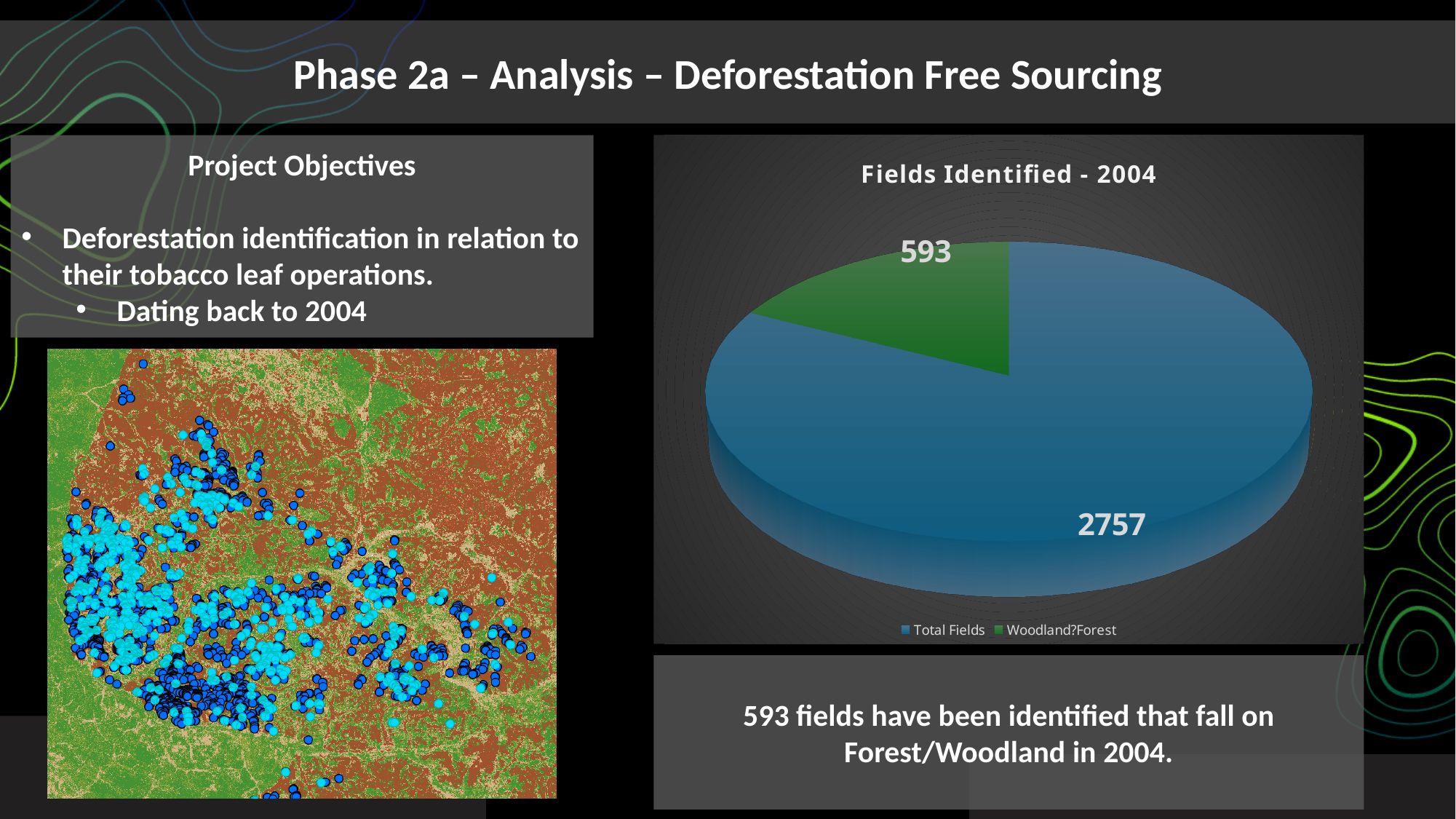
In the "Fields Identified - 2004" chart, what is the sum of the two slice values? 3350 How many entries does the legend of the "Fields Identified - 2004" chart list? 2 What kind of chart is shown under the title "Fields Identified - 2004"? pie chart In the "Fields Identified - 2004" chart, which slice is the smallest? Woodland?Forest In the "Fields Identified - 2004" chart, which is larger: Total Fields or Woodland?Forest? Total Fields What is the title of the pie chart on the slide? Fields Identified - 2004 In the "Fields Identified - 2004" chart, what is the difference between the Total Fields value and the Woodland?Forest value? 2164 In the "Fields Identified - 2004" chart, which slice is the largest? Total Fields How many slices does the "Fields Identified - 2004" pie chart have? 2 In the "Fields Identified - 2004" chart, what is the value for Total Fields? 2757 In the "Fields Identified - 2004" chart, what is the value for Woodland?Forest? 593 In the "Fields Identified - 2004" chart, what colour is the Woodland?Forest slice? green